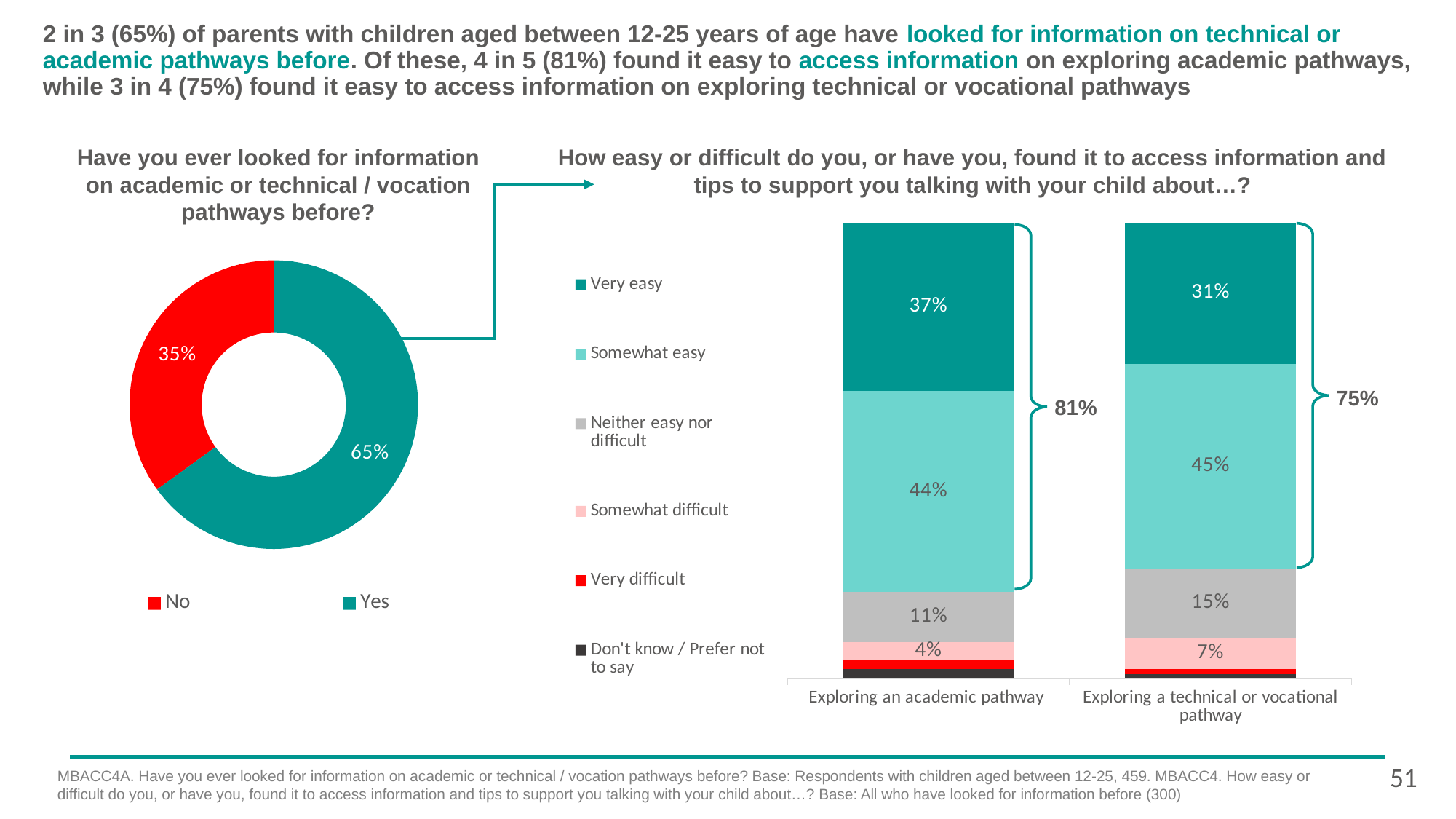
In the right stacked bar chart, what percentage found it 'Somewhat easy' to access information on exploring a technical or vocational pathway? 45% In the left donut chart, what percentage of parents answered 'Yes'? 65% What kind of chart is the left chart titled 'Have you ever looked for information on academic or technical / vocation pathways before?'? Donut (pie) chart What kind of chart is the right chart titled 'How easy or difficult do you, or have you, found it to access information and tips to support you talking with your child about…?'? Stacked bar chart In the right stacked bar chart, what is the difference between the 'Very easy' shares for the academic pathway (37%) and the technical or vocational pathway (31%)? 6 percentage points In the left donut chart, which slice is larger, 'Yes' or 'No'? Yes How many series does the legend of the right stacked bar chart list? 6 In the right stacked bar chart, which pathway has the larger 'Neither easy nor difficult' share? Exploring a technical or vocational pathway In the right stacked bar chart, what combined percentage is shown by the bracket for 'Exploring a technical or vocational pathway'? 75% How many bars (categories) are shown in the right stacked bar chart? 2 In the right stacked bar chart, what percentage found it 'Very easy' to access information on exploring an academic pathway? 37% In the left donut chart, what percentage of parents answered 'No'? 35%